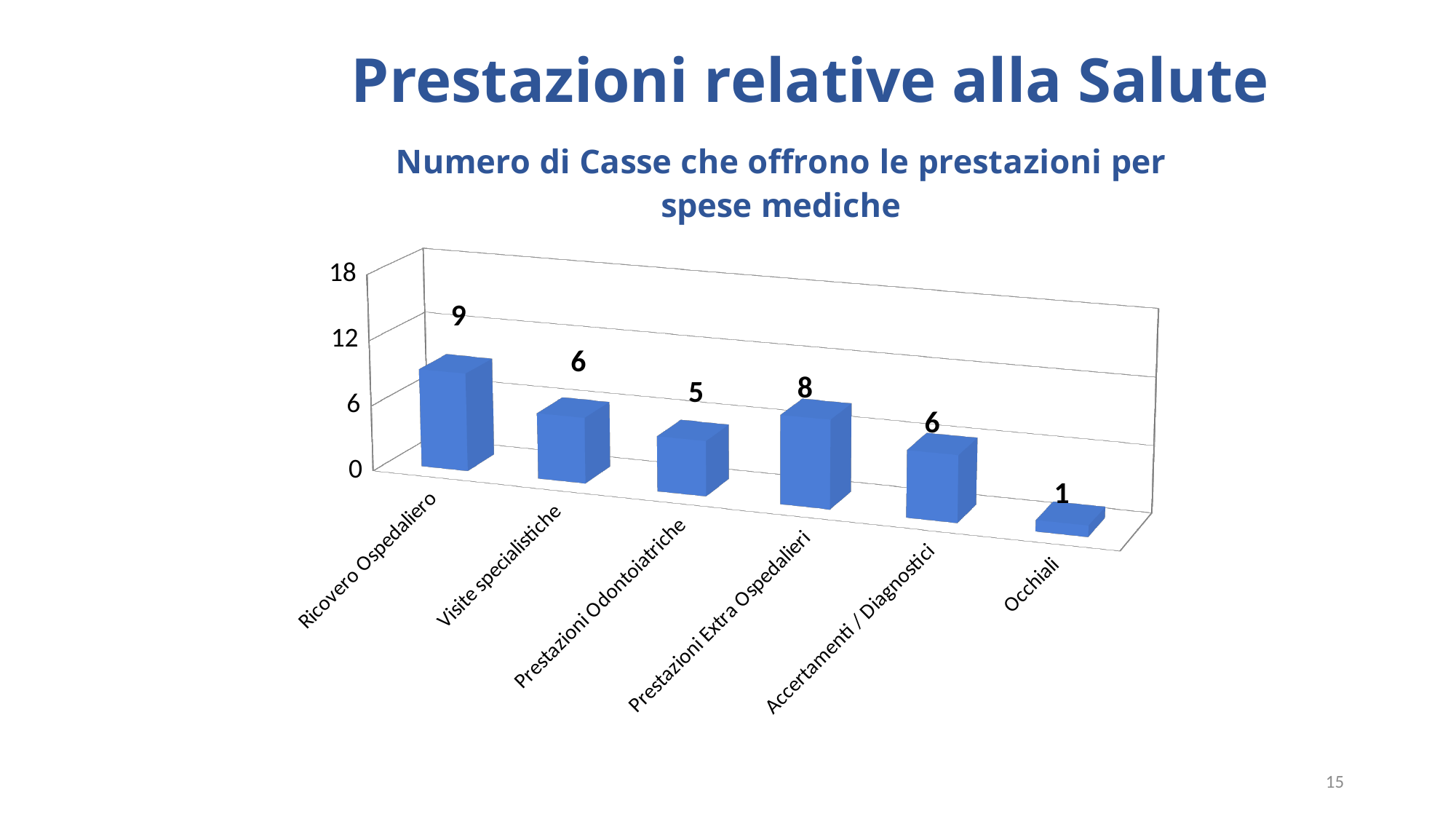
What is the difference between the values for Ricovero Ospedaliero and Prestazioni Extra Ospedalieri? 1 What is the value for Occhiali? 1 Which category has the highest value? Ricovero Ospedaliero What kind of chart is shown on the slide? Bar chart How many categories are shown in the chart? 6 Which is larger, the value for Visite specialistiche or the value for Prestazioni Odontoiatriche? Visite specialistiche Is the value for Prestazioni Extra Ospedalieri greater or less than 6? greater What is the value for Ricovero Ospedaliero? 9 What is the value for Prestazioni Odontoiatriche? 5 Which category has the lowest value? Occhiali What is the value for Prestazioni Extra Ospedalieri? 8 What is the title of the chart? Numero di Casse che offrono le prestazioni per spese mediche